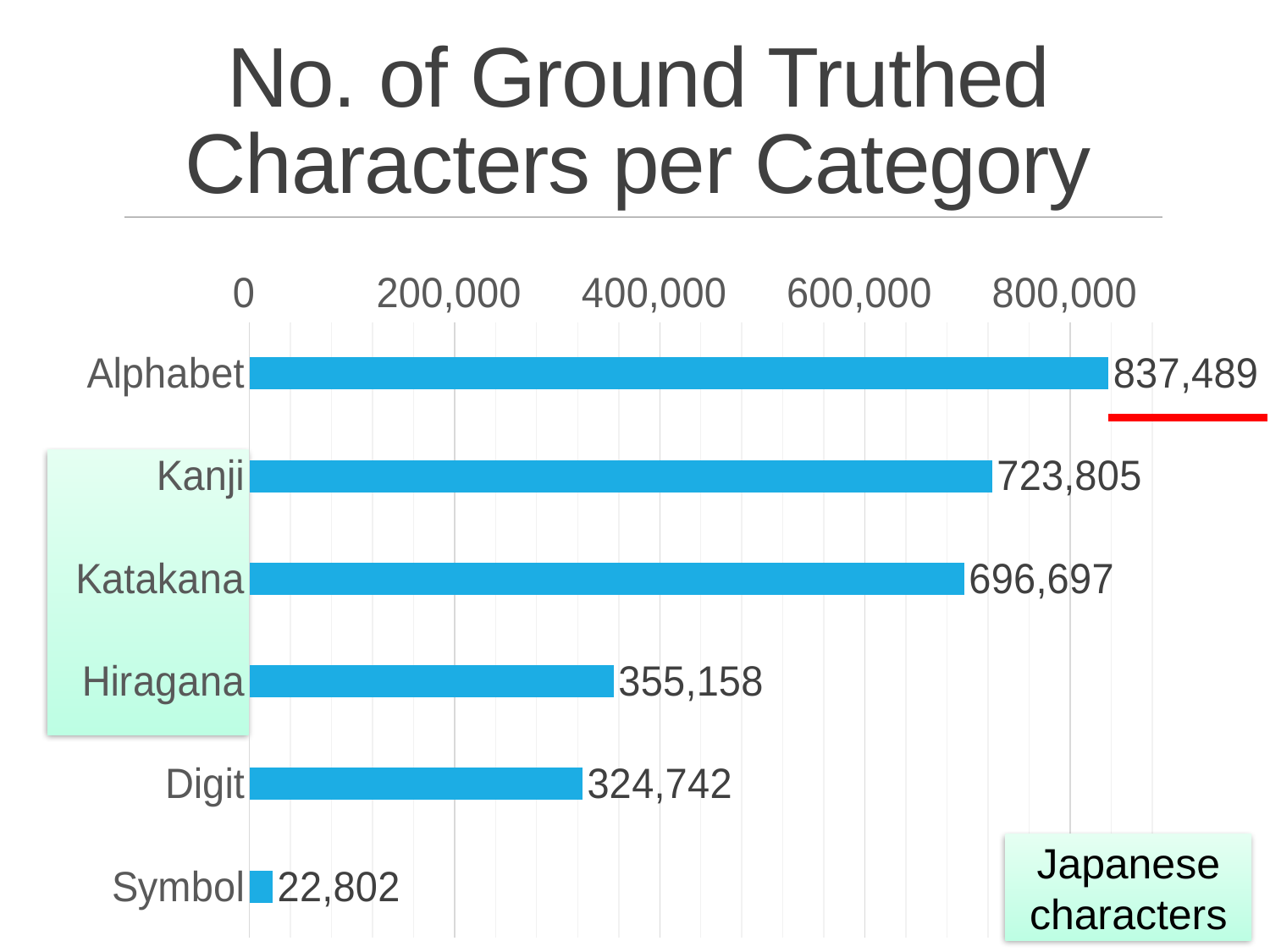
Is the value for Digit greater or less than 400,000? less What is the difference between the Hiragana and Digit values? 30,416 What is the title of the chart? No. of Ground Truthed Characters per Category What is the value shown for Hiragana? 355,158 Which has more ground truthed characters, Katakana or Hiragana? Katakana What kind of chart is shown on the slide? bar chart Which category has the lowest number of ground truthed characters? Symbol What is the number of ground truthed characters for Symbol? 22,802 What is the number of ground truthed characters for Kanji? 723,805 Which category has the highest number of ground truthed characters? Alphabet How many categories are shown in the chart? 6 What is the difference between the Alphabet and Kanji values? 113,684